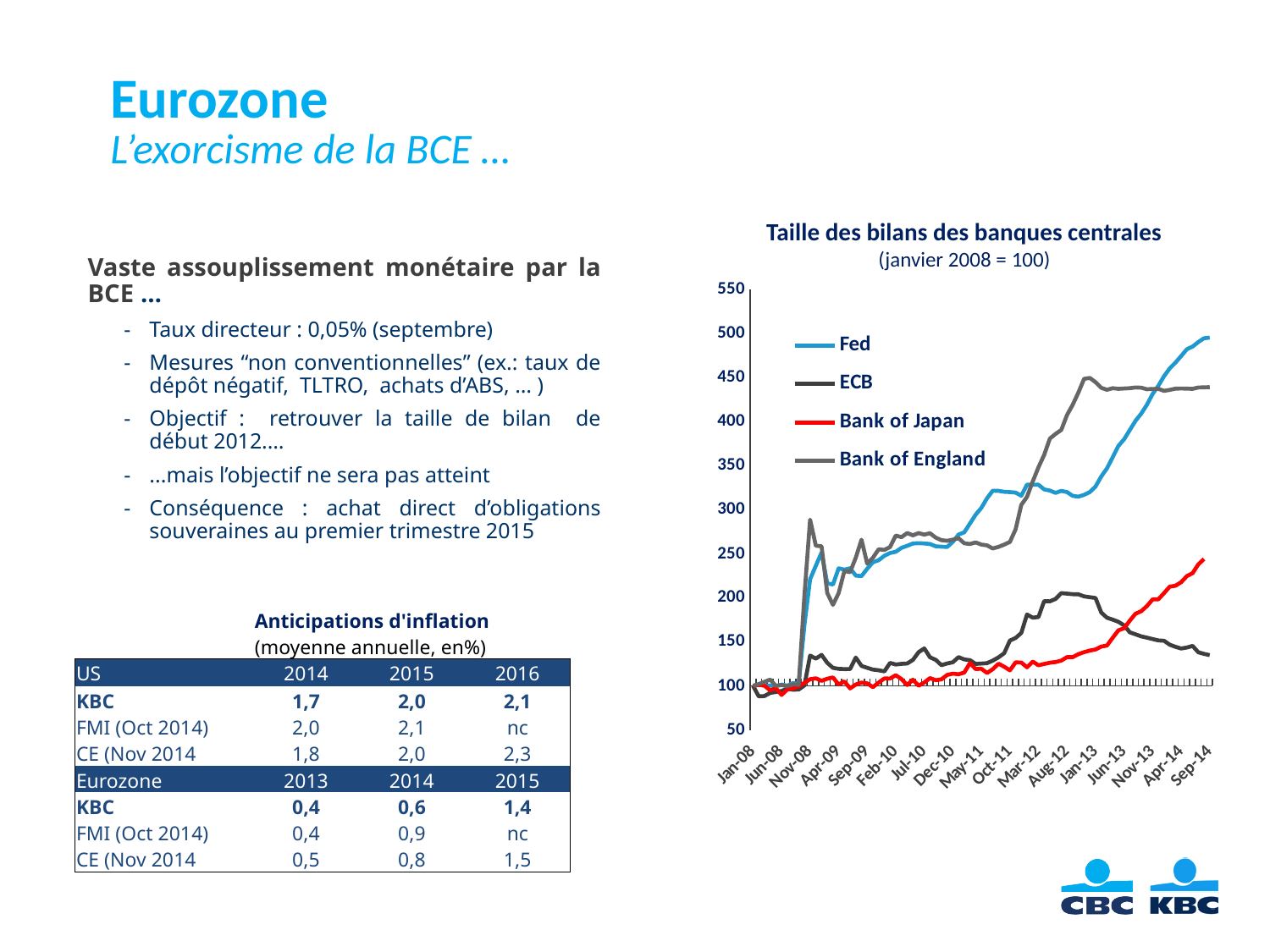
Does the Bank of Japan series rise or fall from Jan-13 to Sep-14? rise According to the chart's subtitle, which month is set equal to 100 as the index base? janvier 2008 Is the value for the Bank of Japan at Sep-14 greater or less than 200? greater What kind of chart is shown on the slide? line chart At Sep-14, which is larger: the Fed or the Bank of Japan? Fed What is the title of the chart? Taille des bilans des banques centrales Is the value for the ECB at Sep-14 greater or less than 150? less How many series does the legend of the chart list? 4 Which series has the highest value at the end of the chart (Sep-14)? Fed Is the value for the Fed at Sep-14 greater or less than 450? greater Which series has the lowest value at the end of the chart (Sep-14)? ECB